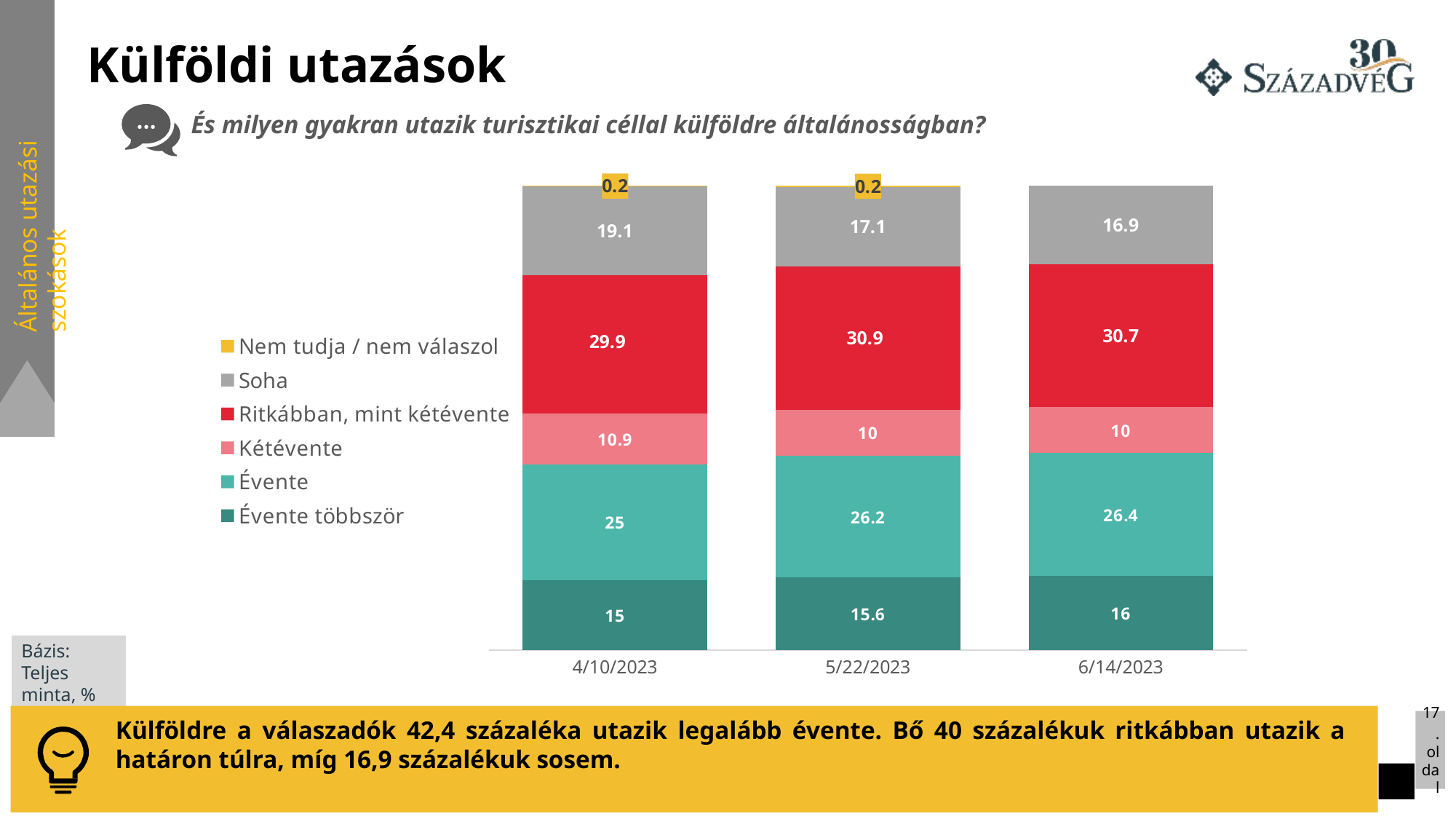
What is the value for 'Soha' on 4/10/2023? 19.1 On which date is the 'Soha' value the highest? 4/10/2023 Which is larger on 5/22/2023: 'Ritkábban, mint kétévente' or 'Évente'? Ritkábban, mint kétévente What kind of chart is shown on the slide? Stacked bar chart On which date is the 'Évente' value the lowest? 4/10/2023 How many dates (categories) are shown on the x axis? 3 Does the 'Évente többször' value rise or fall from 4/10/2023 to 6/14/2023? Rise What is the difference between the 'Évente' values on 6/14/2023 and 4/10/2023? 1.4 How many series does the legend list? 6 What is the value for 'Évente többször' on 6/14/2023? 16 What is the value for 'Kétévente' on 4/10/2023? 10.9 What is the value for 'Ritkábban, mint kétévente' on 5/22/2023? 30.9